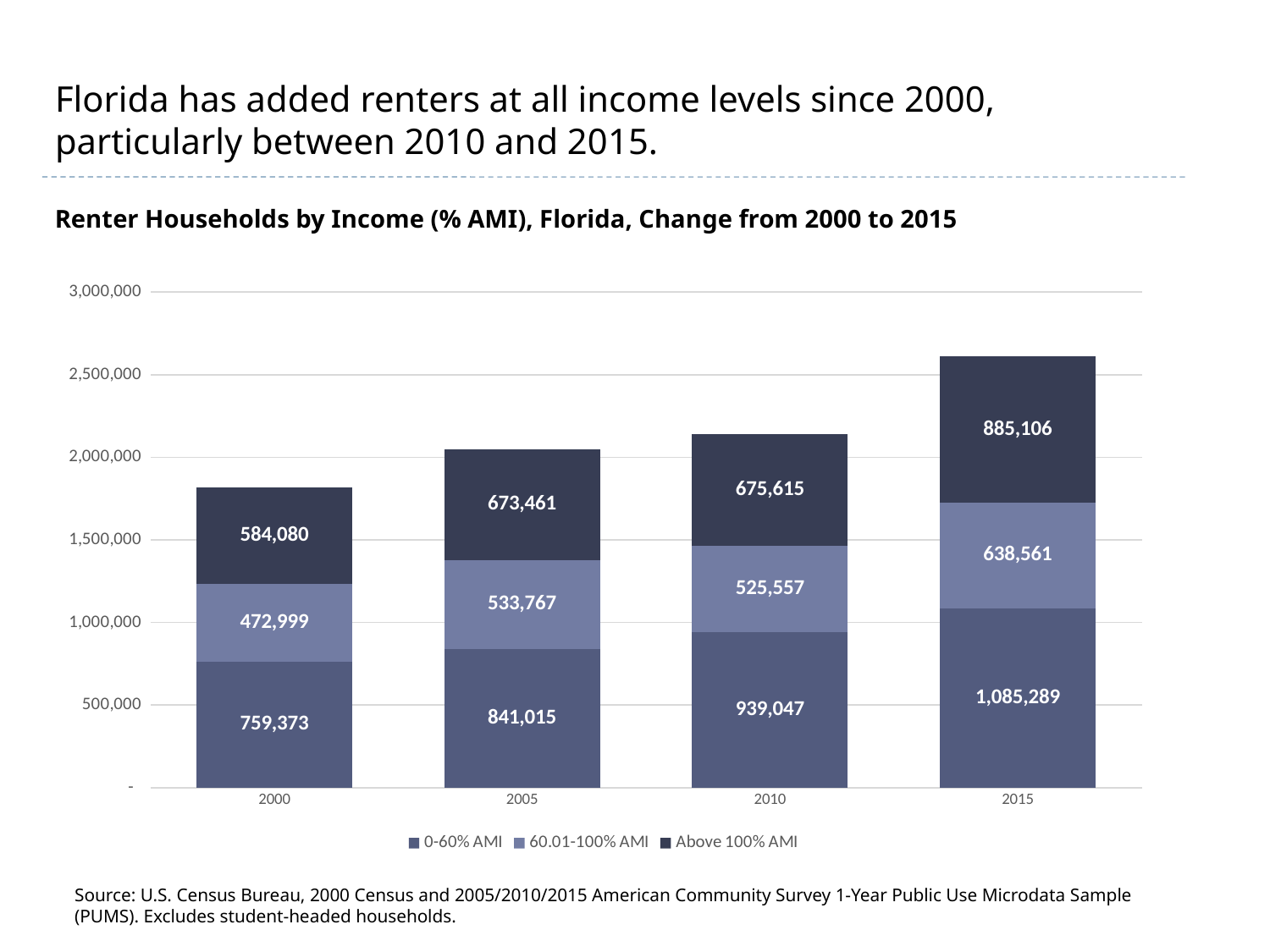
Which is larger: the Above 100% AMI value in 2005 or in 2010? 2010 What is the value for 0-60% AMI in 2015? 1,085,289 What is the value for 60.01-100% AMI in 2010? 525,557 In which year is the 60.01-100% AMI value lowest? 2000 What is the value for Above 100% AMI in 2000? 584,080 How many series does the legend list? 3 How many years are shown on the x axis? 4 What is the difference between the 0-60% AMI values in 2015 and 2000? 325,916 What is the total of the stacked bar for 2015? 2,608,956 What is the total of the stacked bar for 2000? 1,816,452 In which year is the 0-60% AMI value highest? 2015 What kind of chart is shown? Stacked bar chart